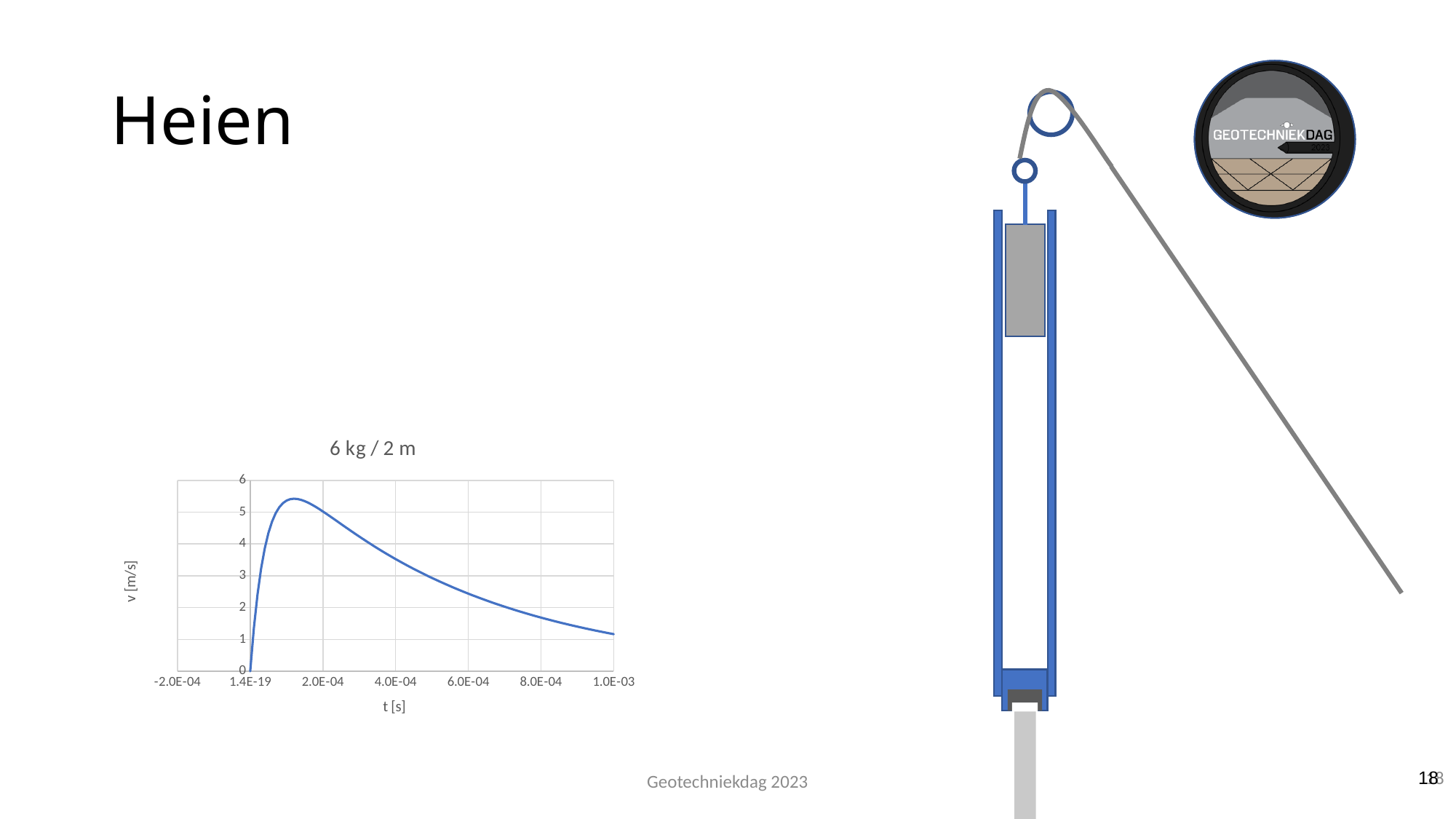
What is the highest tick value shown on the y axis? 6 What is the title of the chart? 6 kg / 2 m Which is larger, the value of v at t = 2.0E-04 or at t = 6.0E-04? t = 2.0E-04 What is the label of the x axis of the chart? t [s] Is the value of v at t = 8.0E-04 greater or less than 2? less What kind of chart is shown on the slide? line chart What is the highest tick value shown on the x axis? 1.0E-03 After reaching its peak, does the curve rise or fall as t increases? fall Is the value of v at t = 1.0E-03 greater or less than 2? less Is the value of v at t = 2.0E-04 greater or less than 4? greater